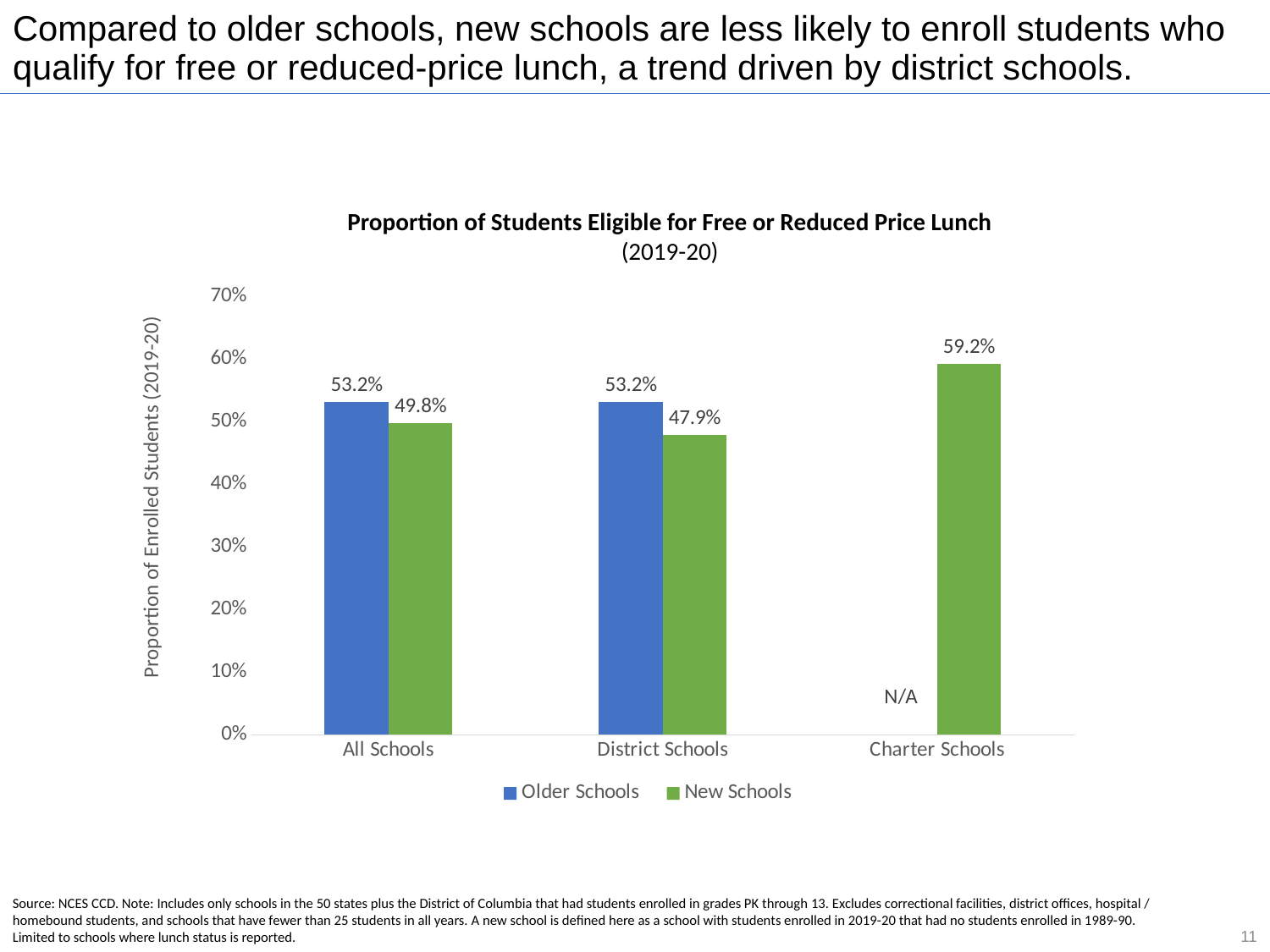
What is the value for New Schools in the Charter Schools category? 59.2% Is the value for New Schools in Charter Schools greater or less than 50%? greater Which category has the lowest value for New Schools? District Schools What is shown for Older Schools in the Charter Schools category? N/A What is the difference between Older Schools and New Schools in the District Schools category? 5.3% What is the value for New Schools in the District Schools category? 47.9% How many series does the legend list? 2 What is the value for Older Schools in the All Schools category? 53.2% Which category has the highest value for New Schools? Charter Schools What kind of chart is this? Bar chart How many categories are shown on the x axis? 3 In the All Schools category, which is larger: Older Schools or New Schools? Older Schools